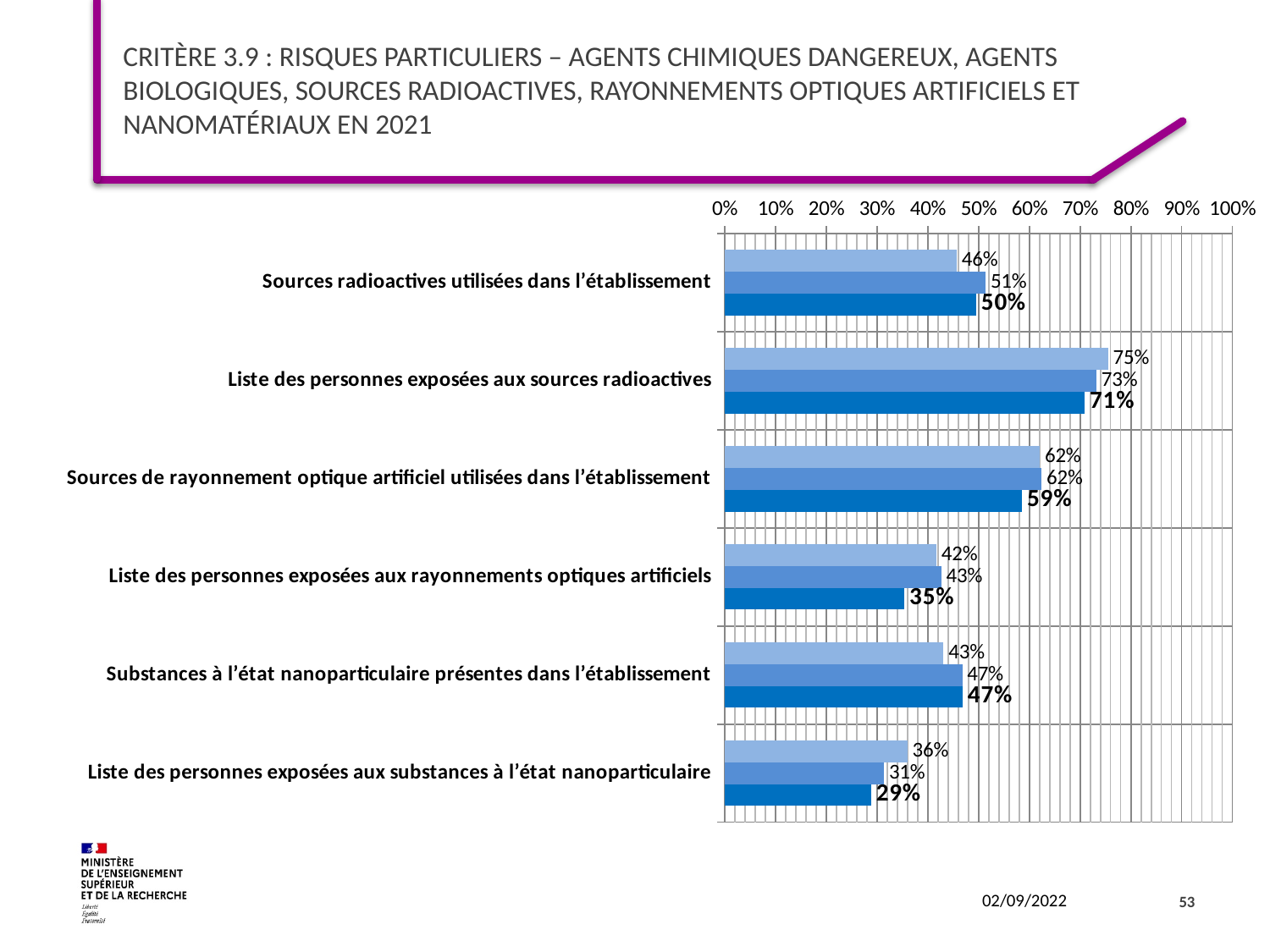
What is the difference between the top bar (75%) and the bottom bar (71%) for "Liste des personnes exposées aux sources radioactives"? 4% What is the value of the bottom (dark blue) bar for "Liste des personnes exposées aux substances à l’état nanoparticulaire"? 29% How many categories are shown on the chart? 6 Which category has the highest value among the bottom (dark blue) bars? Liste des personnes exposées aux sources radioactives What is the value of the top (light blue) bar for "Sources radioactives utilisées dans l’établissement"? 46% What is the value of the middle bar for "Substances à l’état nanoparticulaire présentes dans l’établissement"? 47% What is the value of the bottom (dark blue) bar for "Liste des personnes exposées aux sources radioactives"? 71% What kind of chart is shown on the slide? bar chart For "Liste des personnes exposées aux rayonnements optiques artificiels", which is larger: the middle bar or the bottom bar? the middle bar (43%) Is the bottom (dark blue) bar for "Sources de rayonnement optique artificiel utilisées dans l’établissement" greater or less than 50%? greater Which category has the lowest value among the top (light blue) bars? Liste des personnes exposées aux substances à l’état nanoparticulaire What is the maximum value shown on the horizontal axis of the chart? 100%